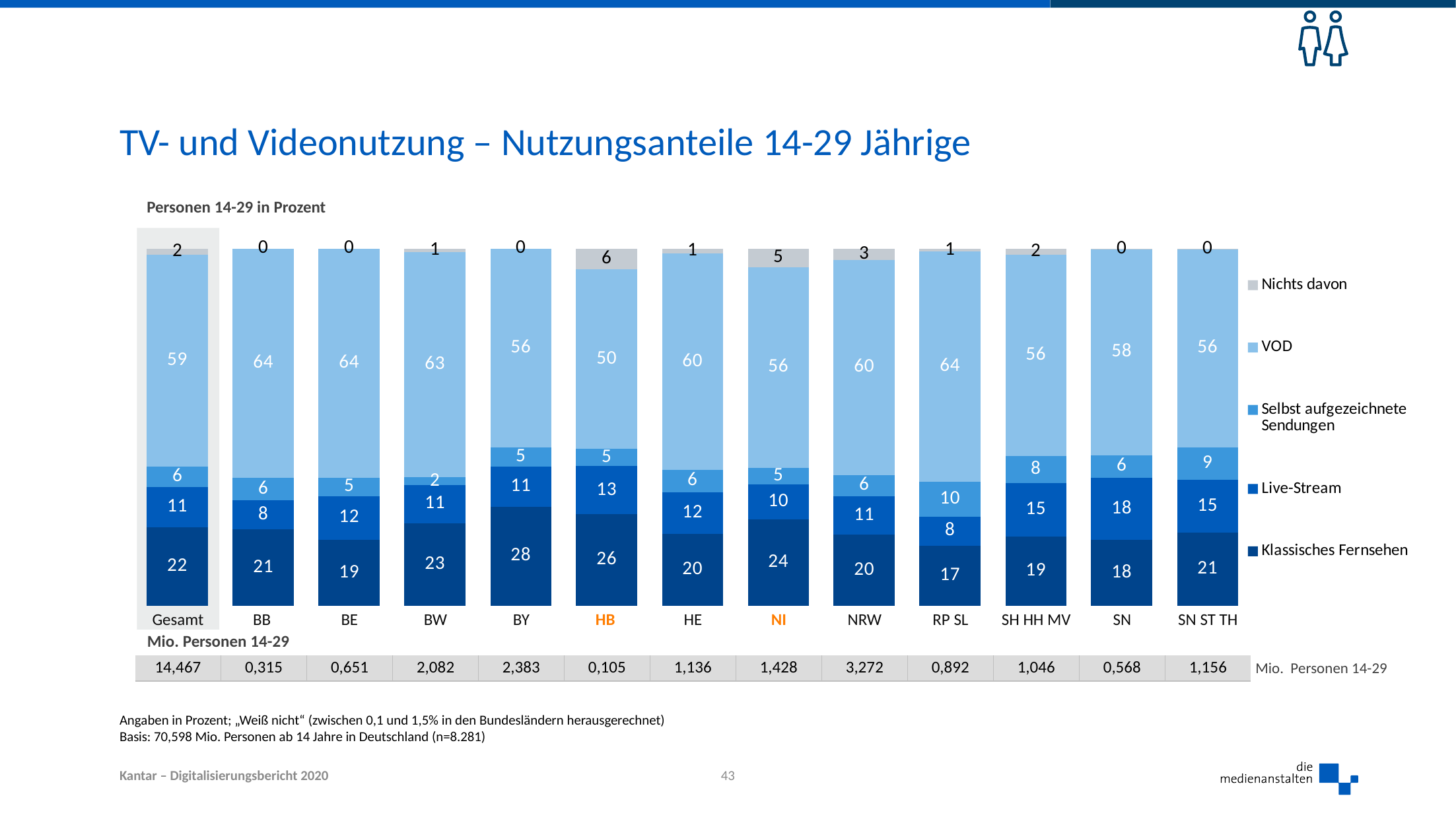
Which category has the highest Klassisches Fernsehen value? BY What kind of chart is shown? Stacked bar chart What is the Klassisches Fernsehen value for BY? 28 How many series does the legend list? 5 What is the VOD value for HB? 50 Which category has the lowest VOD value? HB What is the Live-Stream value for SN? 18 How many categories are shown on the x axis? 13 What is the total of the stacked bar for HB? 100 Which category has the highest Nichts davon value? HB Which is larger, the VOD value for BB or the VOD value for NI? BB What is the difference between the Klassisches Fernsehen values for BY and RP SL? 11